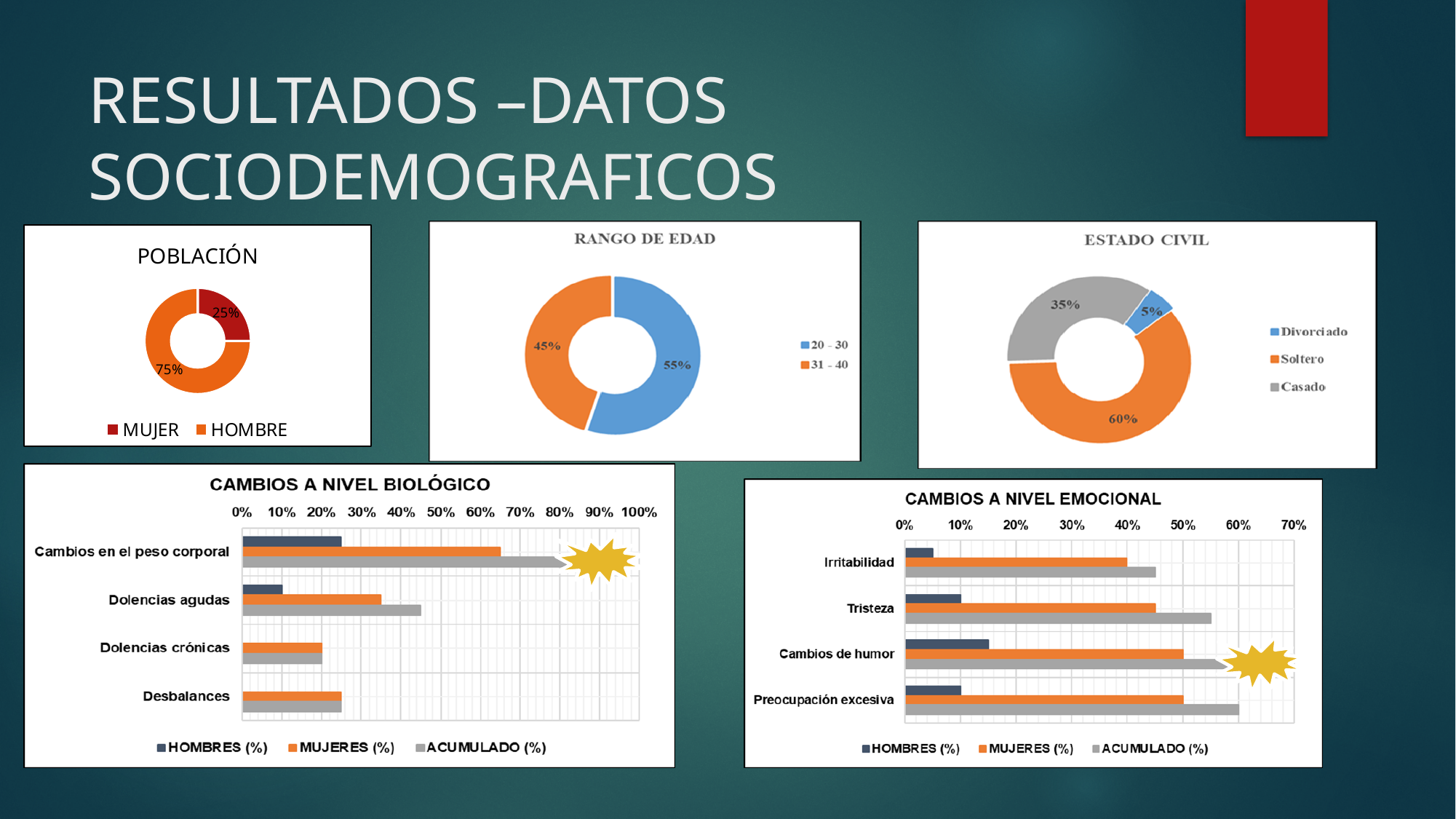
In the ESTADO CIVIL chart, which category has the largest share? Soltero In the CAMBIOS A NIVEL BIOLÓGICO chart, is the ACUMULADO (%) value for Cambios en el peso corporal greater or less than 70%? greater In the CAMBIOS A NIVEL BIOLÓGICO chart, how many categories are shown? 4 In the POBLACIÓN chart, which group is larger, MUJER or HOMBRE? HOMBRE In the POBLACIÓN chart, what share of the population is HOMBRE? 75% In the ESTADO CIVIL chart, what is the difference between the Soltero and Casado shares? 25% In the RANGO DE EDAD chart, what is the value for the 20 - 30 group? 55% In the CAMBIOS A NIVEL BIOLÓGICO chart, how many series does the legend list? 3 In the CAMBIOS A NIVEL EMOCIONAL chart, is the MUJERES (%) value for Irritabilidad greater or less than 50%? less In the RANGO DE EDAD chart, what is the difference between the 20 - 30 and 31 - 40 shares? 10% In the ESTADO CIVIL chart, which category has the smallest share? Divorciado In the CAMBIOS A NIVEL EMOCIONAL chart, which category has the highest HOMBRES (%) value? Cambios de humor